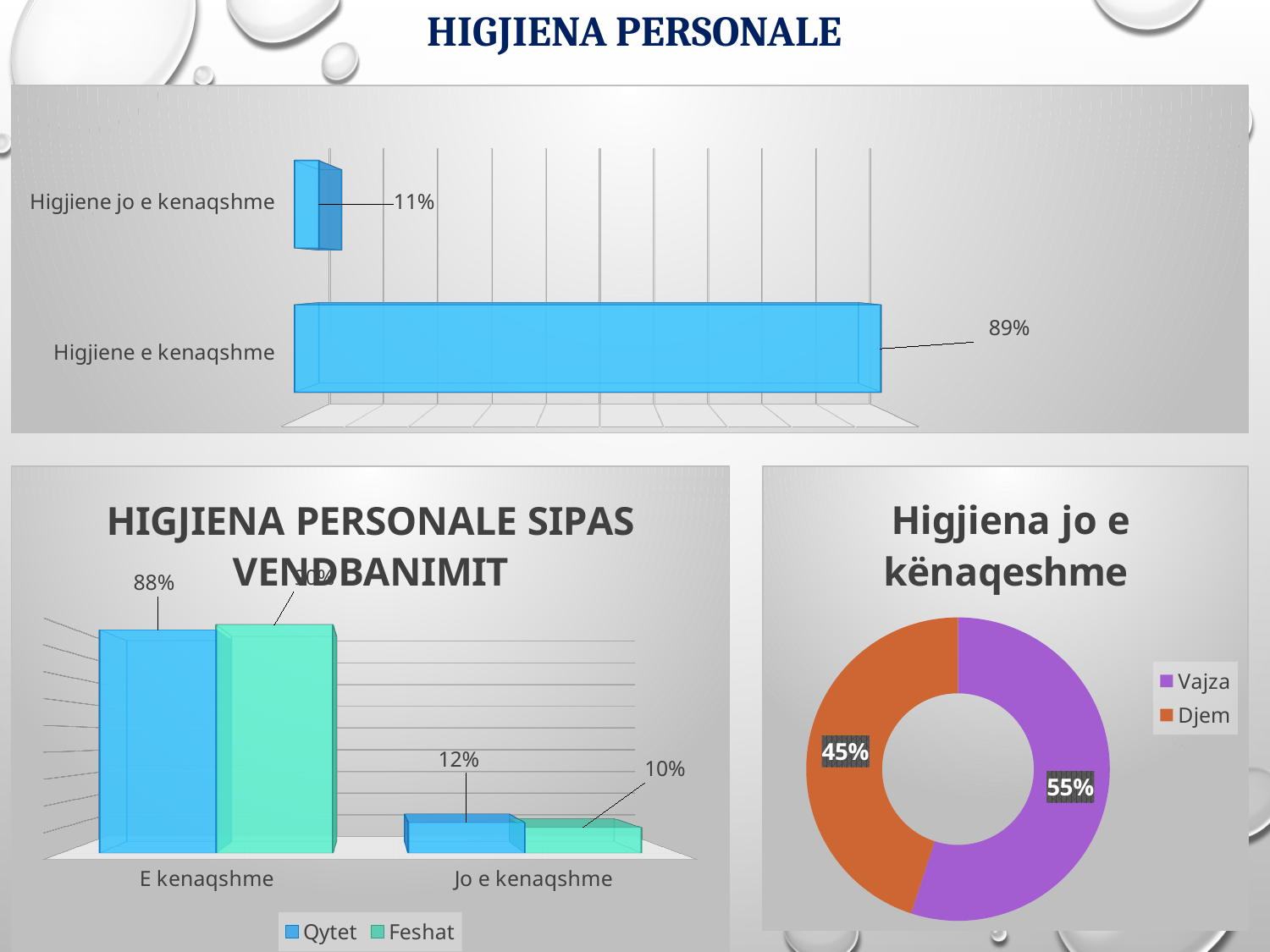
In the top chart, which category has the highest value? Higjiene e kenaqshme In the top chart, what is the value for Higjiene e kenaqshme? 89% In the chart titled HIGJIENA PERSONALE SIPAS VENDBANIMIT, how many series does the legend list? 2 In the chart titled HIGJIENA PERSONALE SIPAS VENDBANIMIT, what is the value for Qytet in the E kenaqshme category? 88% In the chart titled HIGJIENA PERSONALE SIPAS VENDBANIMIT, which series is larger in the Jo e kenaqshme category, Qytet or Feshat? Qytet In the top chart, what is the difference between Higjiene e kenaqshme and Higjiene jo e kenaqshme? 78% In the chart titled Higjiena jo e kënaqeshme, which slice is larger, Vajza or Djem? Vajza In the chart titled HIGJIENA PERSONALE SIPAS VENDBANIMIT, what is the value for Feshat in the Jo e kenaqshme category? 10% What kind of chart is the top chart on the slide? Bar chart In the top chart, what is the value for Higjiene jo e kenaqshme? 11% In the chart titled HIGJIENA PERSONALE SIPAS VENDBANIMIT, what is the value for Qytet in the Jo e kenaqshme category? 12% In the chart titled Higjiena jo e kënaqeshme, what share does Vajza have? 55%